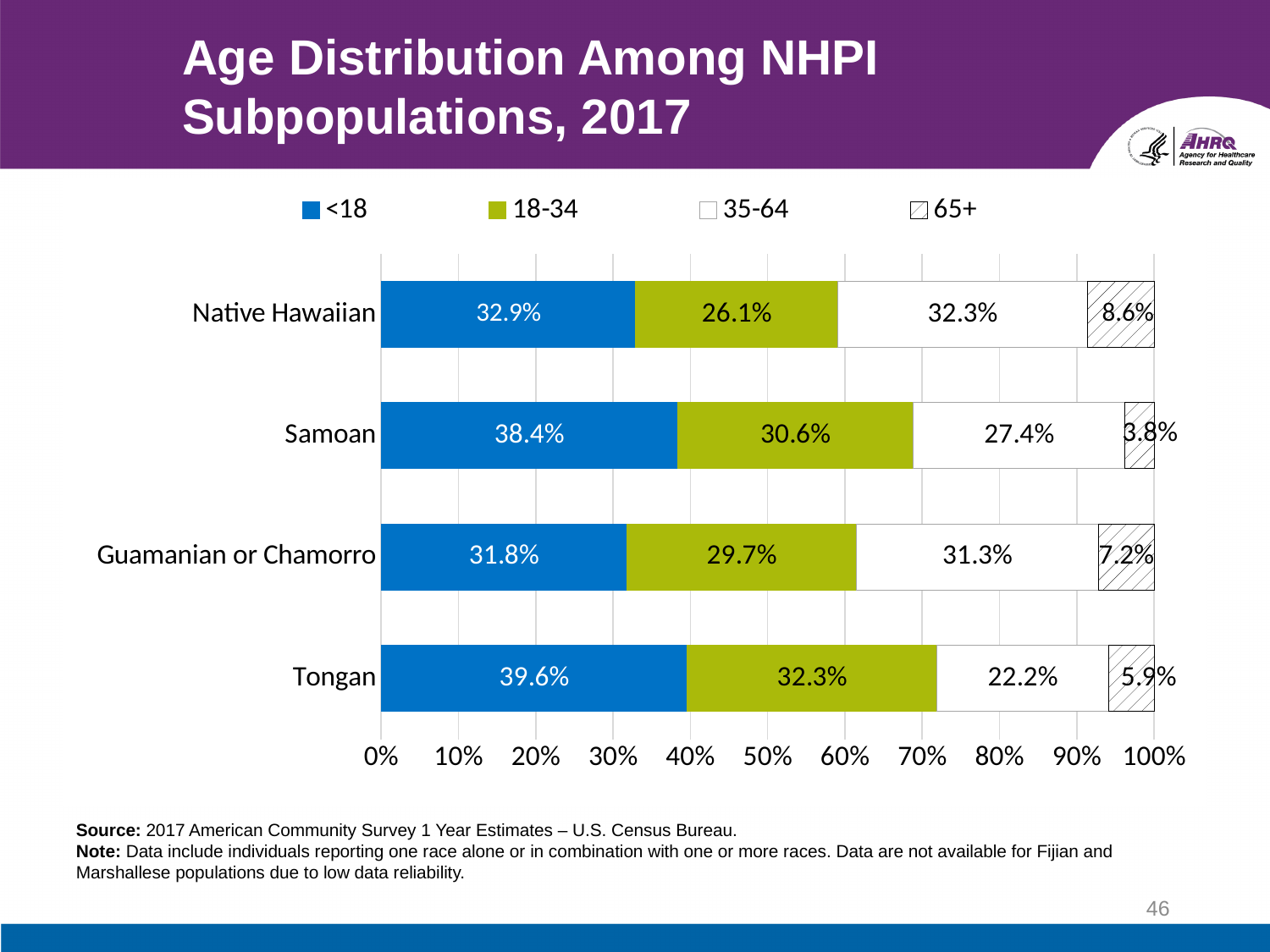
Which subpopulation has the highest share of people under 18? Tongan What percentage of the Guamanian or Chamorro population is aged 35-64? 31.3% What percentage of the Native Hawaiian population is aged 65+? 8.6% What is the difference between the under-18 share for Tongan and for Guamanian or Chamorro? 7.8 percentage points Which subpopulation has the lowest share of people aged 65+? Samoan What percentage of the Samoan population is under 18? 38.4% Which is larger: the 18-34 share for Samoan or for Native Hawaiian? Samoan Which age group is shown with a hatched pattern in the legend? 65+ What kind of chart is shown on the slide? Stacked bar chart How many NHPI subpopulations are shown in the chart? 4 Is the 35-64 share for Tongan greater or less than 30%? less How many age groups does the legend list? 4